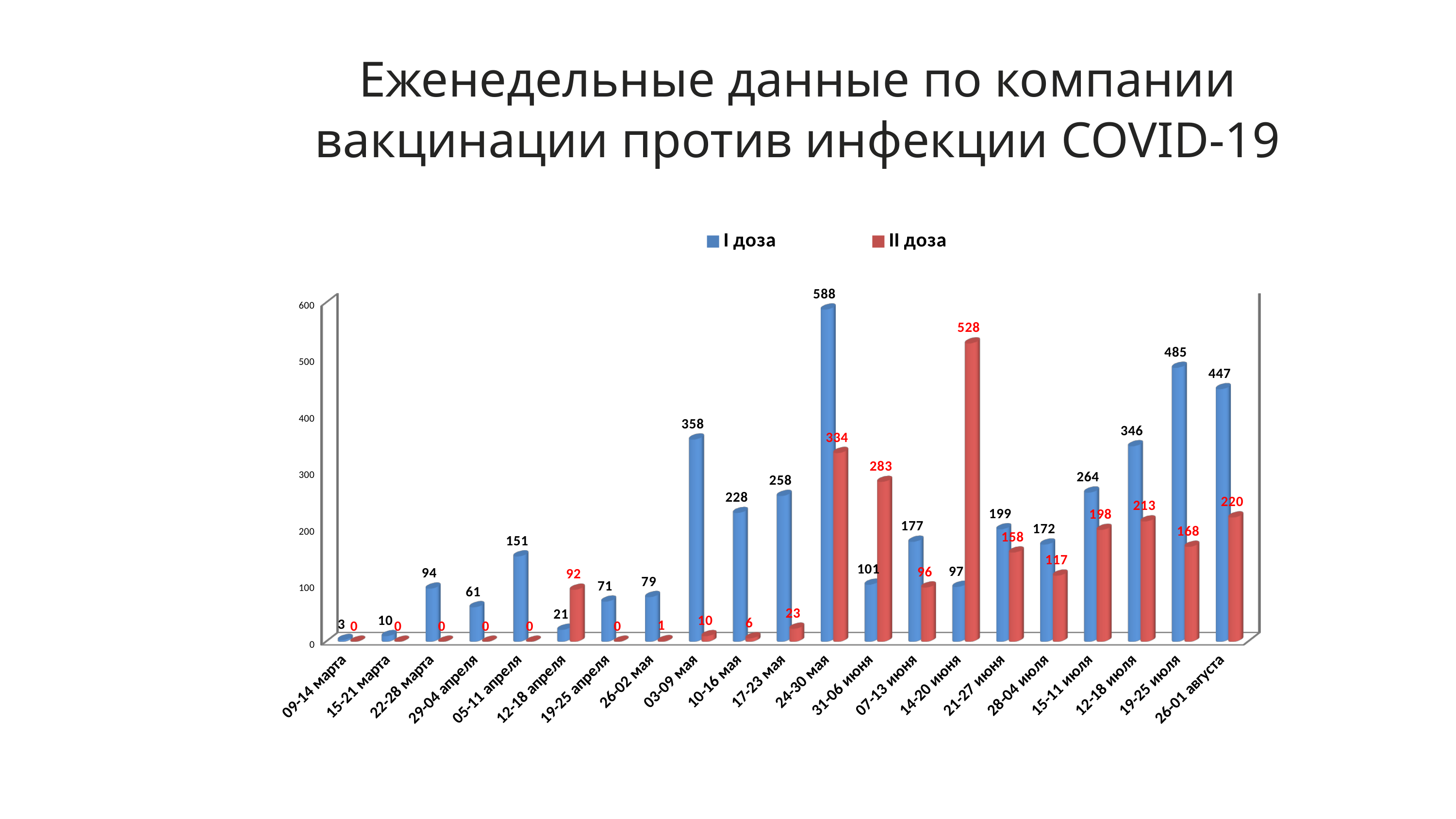
What is the difference between II доза and I доза for 14-20 июня? 431 What is the value of II доза for 12-18 апреля? 92 What is the value of II доза for 14-20 июня? 528 What is the difference between I доза and II доза for 24-30 мая? 254 Which is larger for 12-18 апреля, I доза or II доза? II доза How many series does the legend list? 2 What is the value of I доза for 19-25 июля? 485 Which week has the highest value for II доза? 14-20 июня Which week has the highest value for I доза? 24-30 мая How many weeks (categories) are shown on the x axis? 21 What is the value of I доза for 24-30 мая? 588 What type of chart is shown on the slide? bar chart